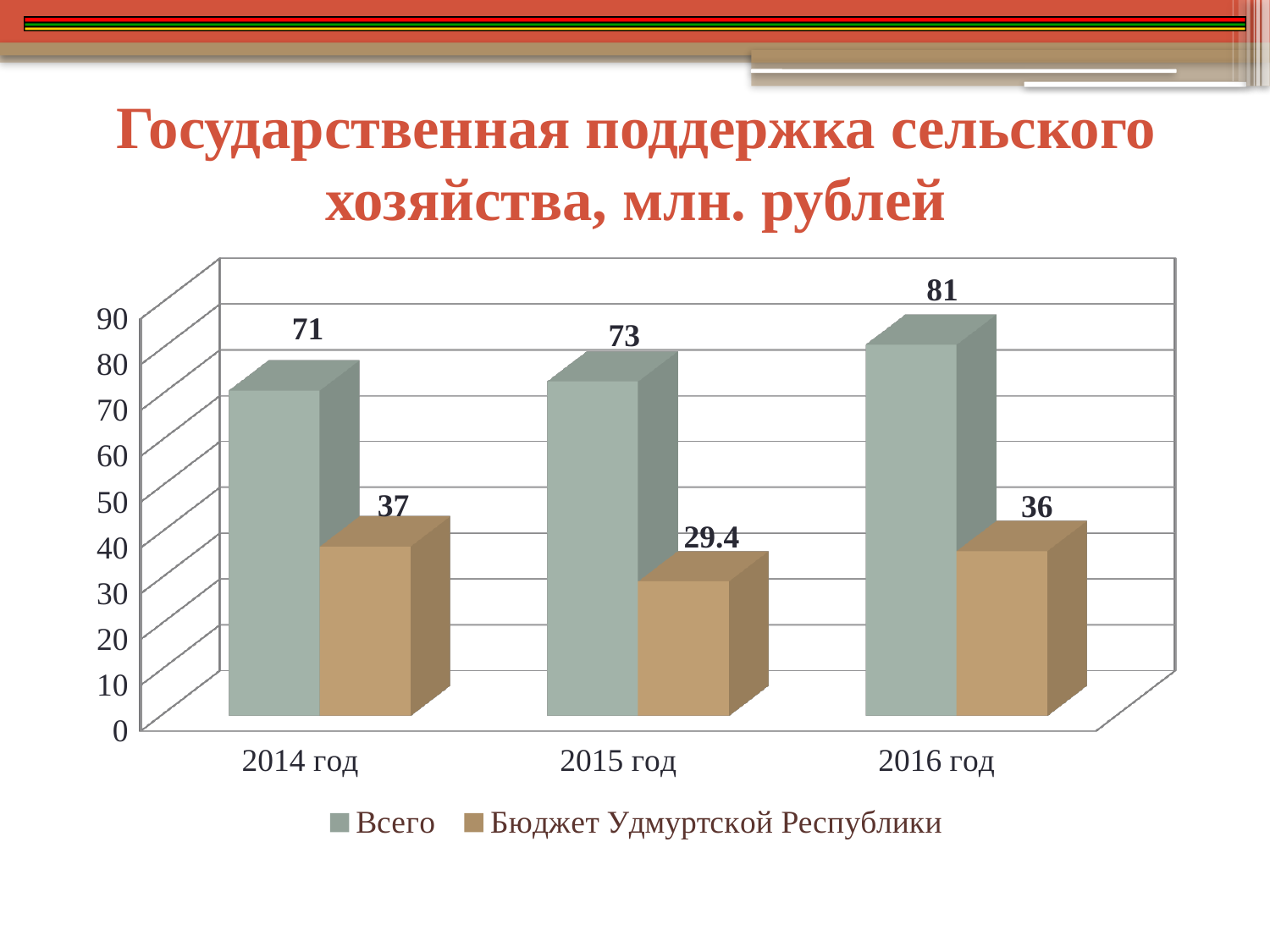
Does the value of "Всего" rise or fall from 2014 год to 2016 год? rise Which year has the highest value for "Всего"? 2016 год Which year has the lowest value for "Бюджет Удмуртской Республики"? 2015 год What kind of chart is shown on the slide? bar chart What is the value of "Всего" for 2016 год? 81 How many years are shown on the x axis? 3 What is the value of "Бюджет Удмуртской Республики" for 2015 год? 29.4 What is the value of "Всего" for 2014 год? 71 What is the difference between "Всего" and "Бюджет Удмуртской Республики" in 2016 год? 45 Which is larger: "Бюджет Удмуртской Республики" in 2014 год or in 2016 год? 2014 год Is the value of "Всего" for 2015 год greater or less than 80? less How many series does the legend list? 2